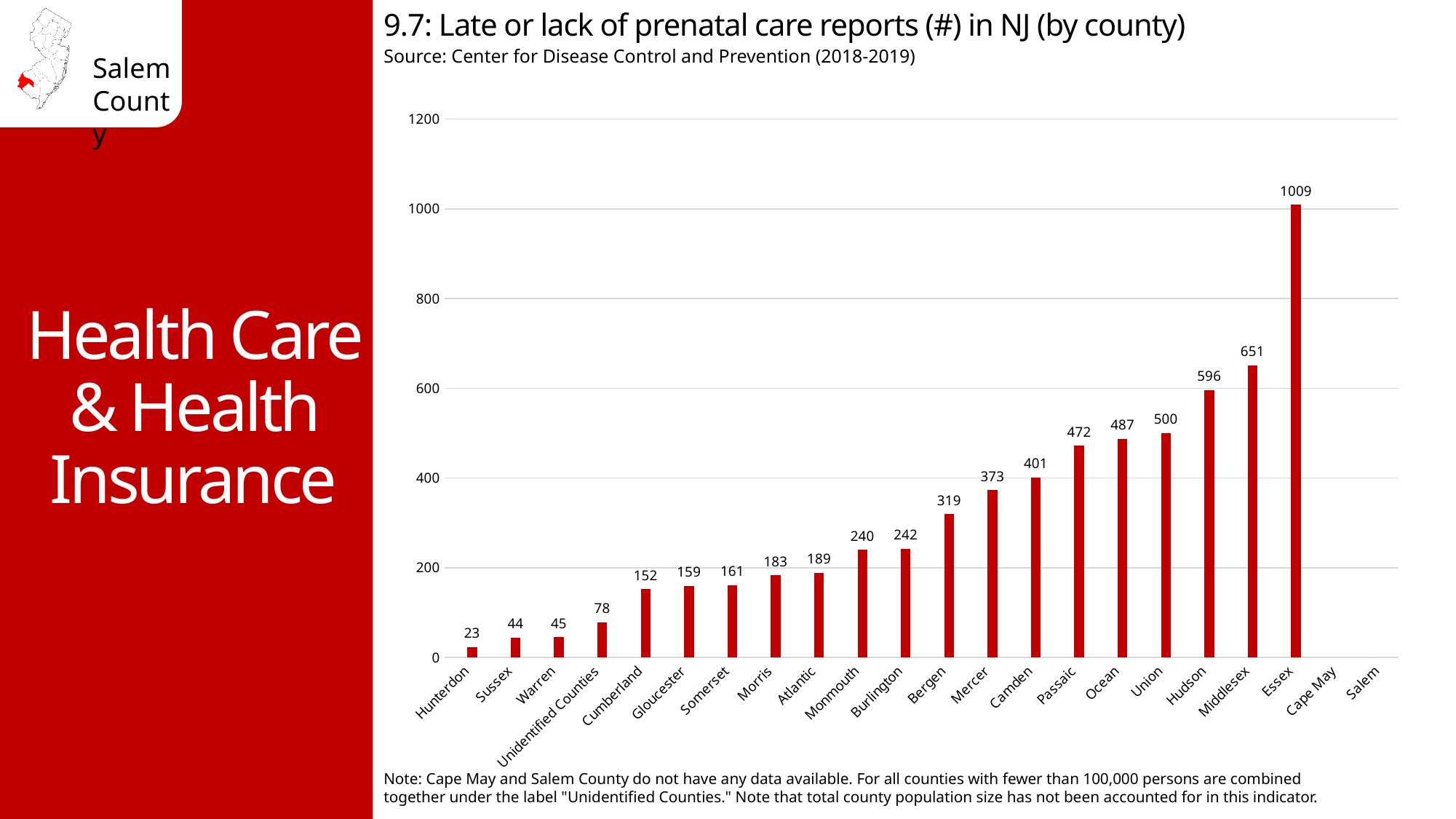
What is the number of late or lack of prenatal care reports for Essex? 1009 Which county has the highest number of late or lack of prenatal care reports? Essex Which has a larger value, Passaic or Bergen? Passaic Is the value for Hudson greater or less than 400? greater What is the difference between the values for Middlesex and Hudson? 55 How many county labels are shown on the x axis? 22 Do the bar values rise or fall from left to right along the x axis? Rise Which county has the lowest number of late or lack of prenatal care reports among those with data? Hunterdon What is the value shown for Unidentified Counties? 78 What is the value shown for Cumberland? 152 What is the difference between the values for Essex and Union? 509 What kind of chart is shown on the slide? Bar chart